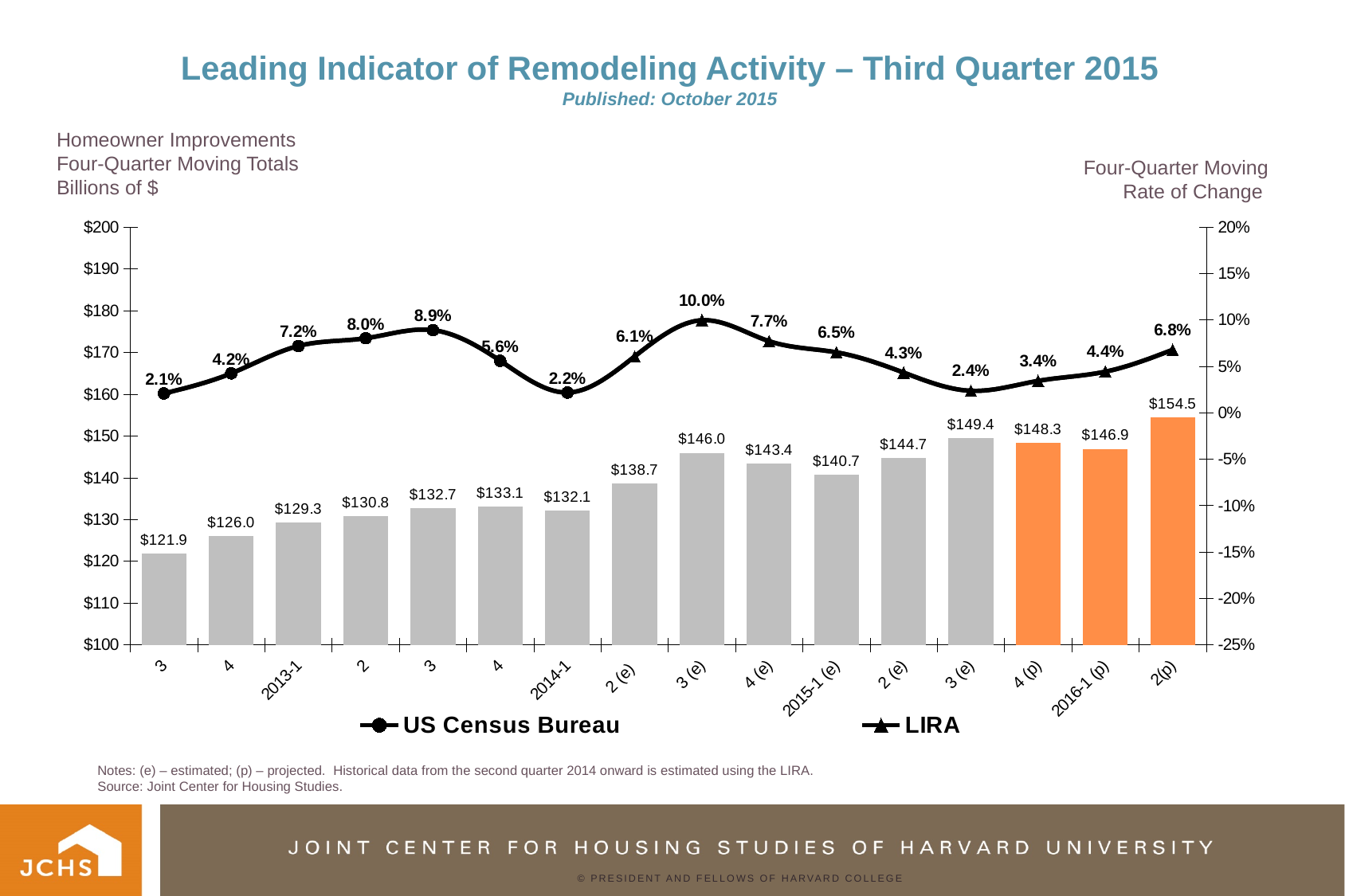
What is the highest four-quarter moving rate of change shown on the line? 10.0% How many series does the legend list? 2 What is the difference between the four-quarter moving totals for 2(p) and 2016-1 (p)? $7.6 What are the two series named in the legend? US Census Bureau and LIRA Which period has the highest four-quarter moving total? 2(p) What is the four-quarter moving total for 2016-1 (p)? $146.9 What is the four-quarter moving total for 2014-1? $132.1 Which period has the lowest four-quarter moving total? 3 (2012) Which is larger, the four-quarter moving total for 3 (e) in 2015 or for 4 (p)? 3 (e) in 2015 How many bars are plotted in the chart? 16 What kind of chart is used to show the four-quarter moving totals? Bar chart What is the four-quarter moving rate of change shown for 3 (e) in 2014? 10.0%